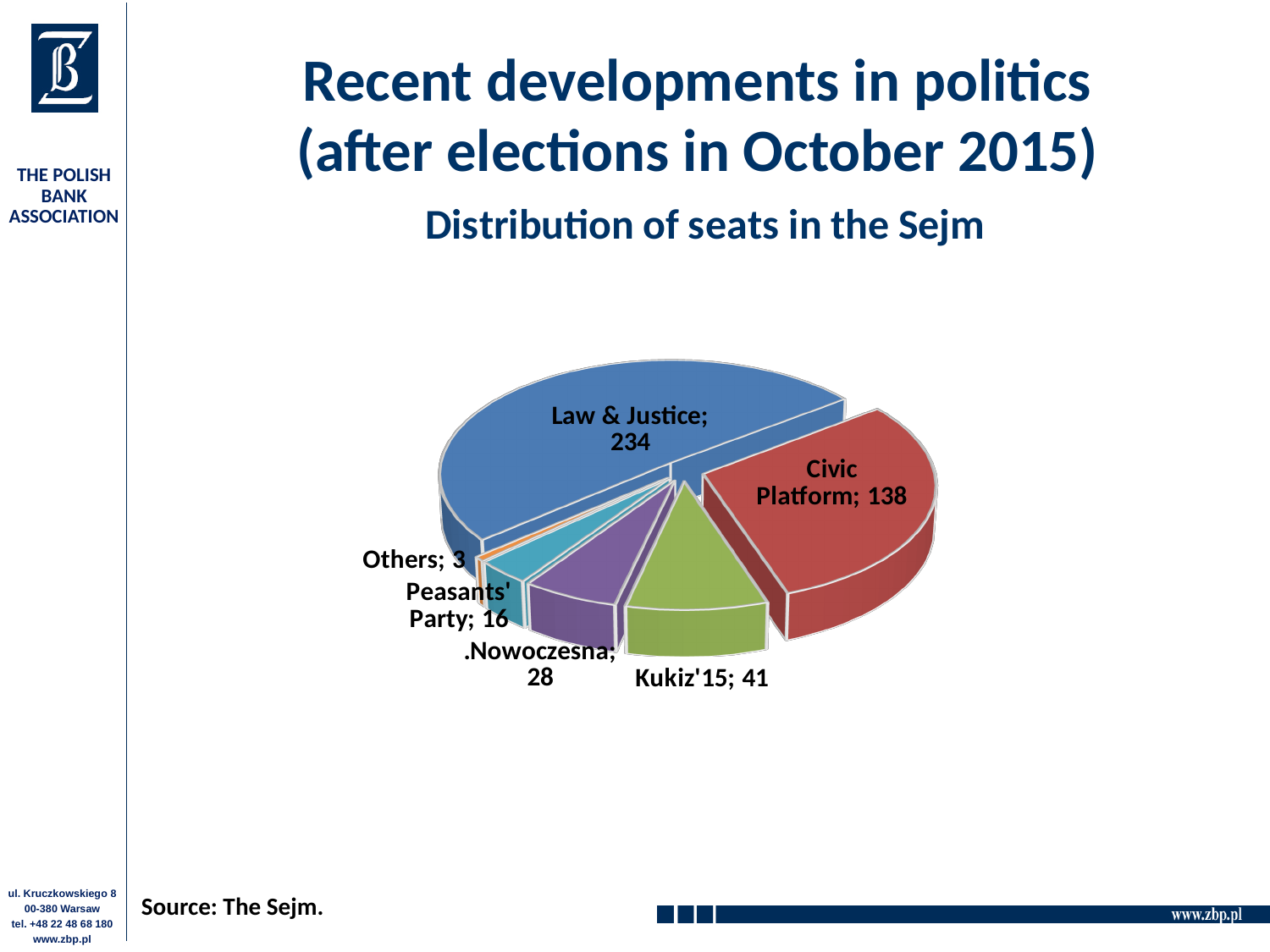
How many seats does Law & Justice hold according to the chart? 234 What is the total number of seats shown across all slices of the pie chart? 460 What is the difference in seats between Law & Justice and Civic Platform? 96 How many categories (slices) does the pie chart show? 6 Which has more seats, .Nowoczesna or Kukiz'15? Kukiz'15 Which party has the largest number of seats in the chart? Law & Justice Which category has the smallest number of seats in the chart? Others How many seats does the Peasants' Party hold according to the chart? 16 How many seats does Civic Platform hold according to the chart? 138 How many seats does Kukiz'15 hold according to the chart? 41 What kind of chart is shown on the slide? Pie chart What share of the total seats does Civic Platform hold? 30%